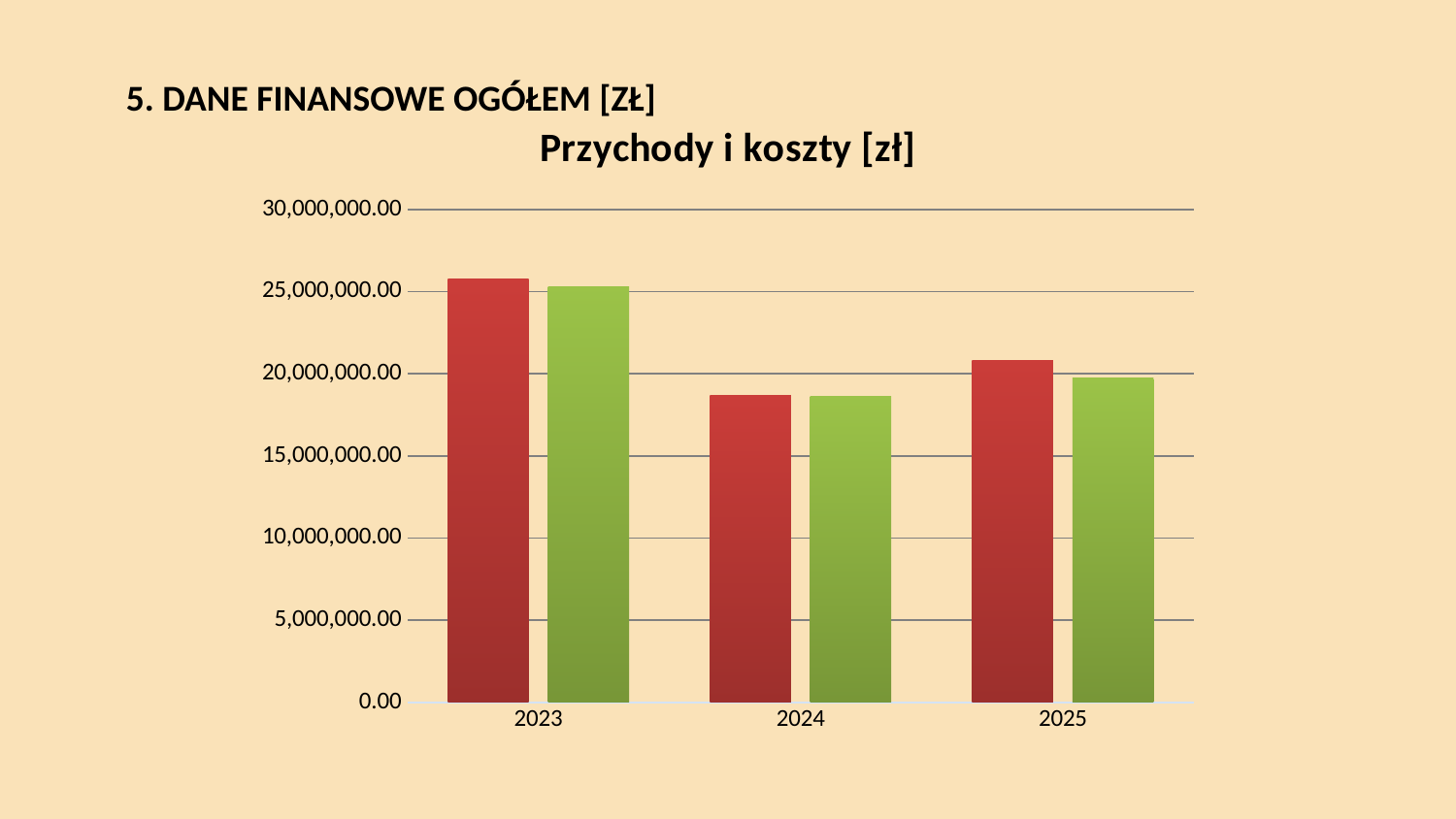
What is the title of the chart? Przychody i koszty [zł] Is the value of the red bar for 2024 greater or less than 20,000,000.00? less How many bars are shown for each year in the chart? 2 How many years are shown on the x axis of the chart? 3 Is the value of the red bar for 2025 greater or less than 20,000,000.00? greater What kind of chart is shown on the slide? bar chart In which year is the green bar the highest? 2023 Do the red bars rise or fall from 2023 to 2024? fall Which is larger, the green bar for 2024 or the green bar for 2025? 2025 In which year is the red bar the lowest? 2024 In which year is the red bar the highest? 2023 Is the value of the red bar for 2023 greater or less than 25,000,000.00? greater